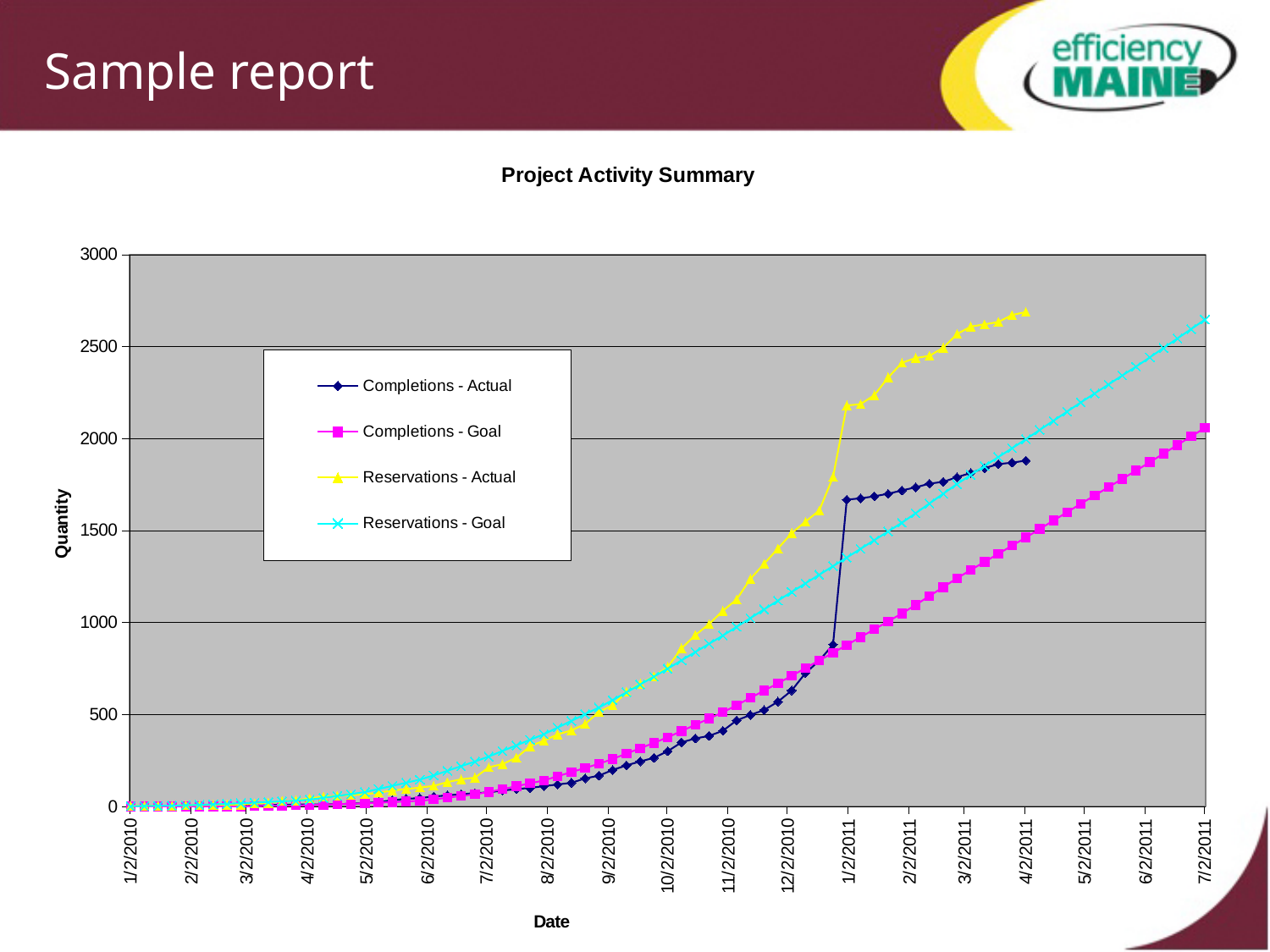
Is the value for Reservations - Goal at 7/2/2011 greater or less than 2500? greater At 7/2/2011, which series has the higher value: Reservations - Goal or Completions - Goal? Reservations - Goal What kind of chart is shown on the slide? Line chart How many series does the legend of the Project Activity Summary chart list? 4 What is the title of the chart on the slide? Project Activity Summary At 4/2/2011, which series has the higher value: Reservations - Actual or Completions - Actual? Reservations - Actual Do the values for Reservations - Goal rise or fall along the x axis from 1/2/2010 to 7/2/2011? Rise Is the value for Completions - Actual at 4/2/2011 greater or less than 2000? less Is the value for Completions - Goal at 7/2/2011 greater or less than 1500? greater What is the label on the vertical axis of the chart? Quantity